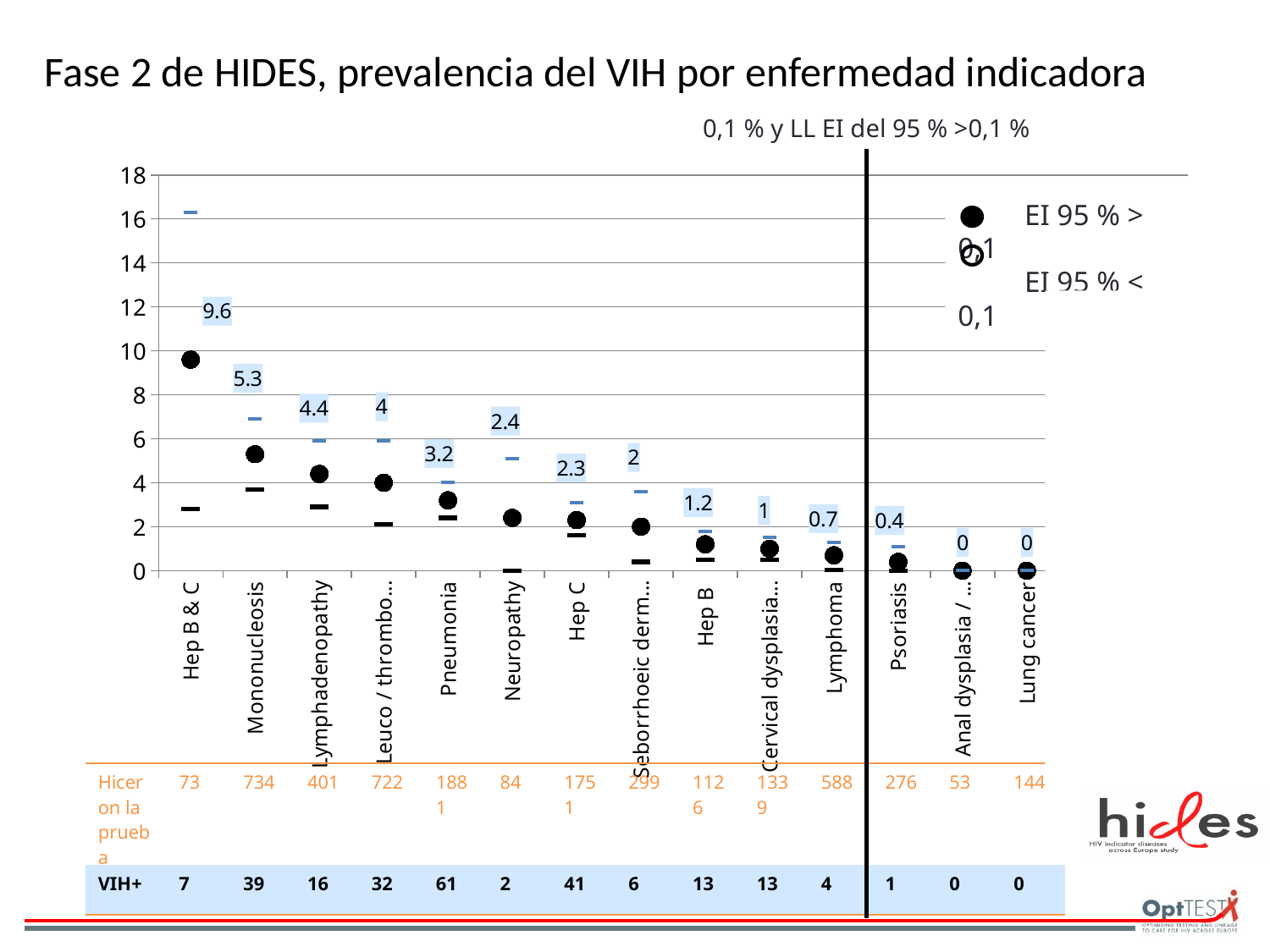
What is the HIV prevalence value shown for Hep B & C? 9.6 What is the value labelled for Pneumonia? 3.2 Do the labelled prevalence values rise or fall from left to right along the x axis? fall What is the value labelled for Mononucleosis? 5.3 According to the 'Hicieron la prueba' row, how many people were tested for Lymphoma? 588 According to the VIH+ row, how many HIV-positive cases were found for Pneumonia? 61 How many entries does the legend list? 2 How many indicator diseases are plotted along the x axis? 14 What is the title of the slide's chart? Fase 2 de HIDES, prevalencia del VIH por enfermedad indicadora Which has a larger labelled value, Hep C or Hep B? Hep C What is the difference between the labelled values for Hep B & C and Mononucleosis? 4.3 Which indicator disease has the highest labelled prevalence value? Hep B & C